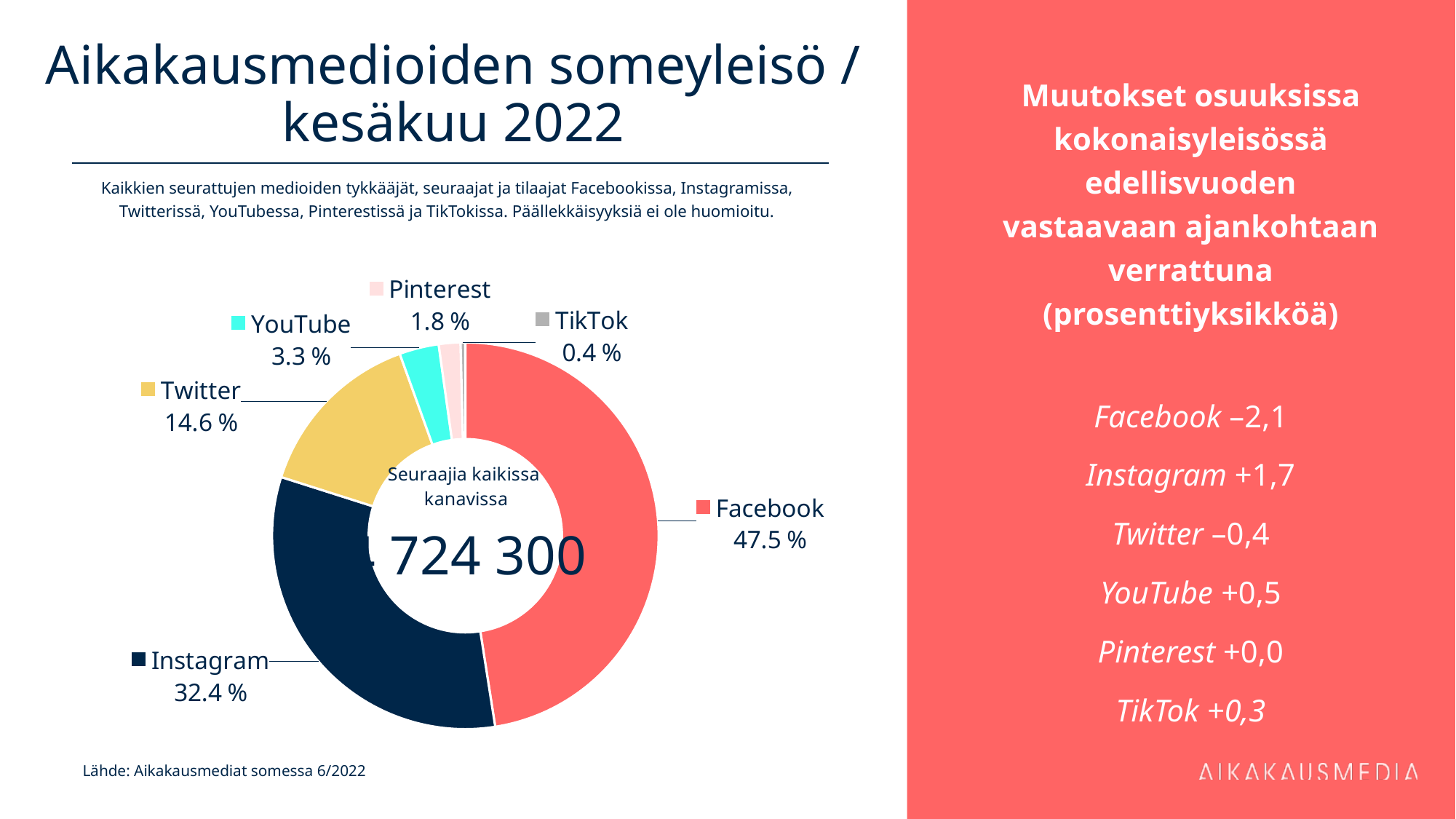
What is the combined share of Pinterest and TikTok? 2.2 % What share does Twitter have in the chart? 14.6 % What share does TikTok have in the chart? 0.4 % What kind of chart is shown on the slide? Pie chart (donut) Which has a larger share, Twitter or YouTube? Twitter What share of the social media audience does Facebook have? 47.5 % Which channel has the largest share of the audience? Facebook How many channels are shown in the chart? 6 Which channel has the smallest share of the audience? TikTok What share does YouTube have in the chart? 3.3 % How many percentage points larger is Facebook's share than Instagram's? 15.1 What share of the social media audience does Instagram have? 32.4 %